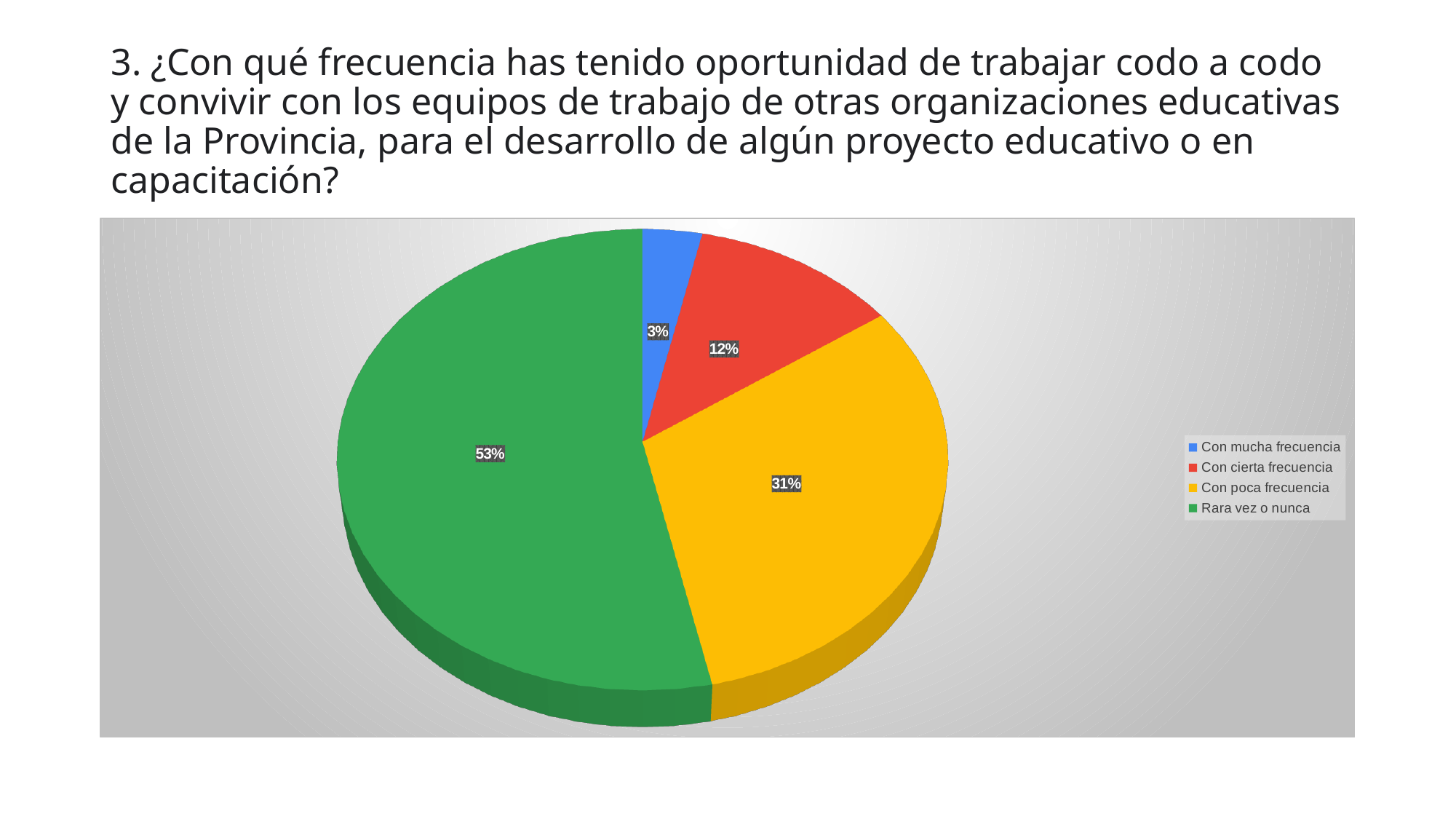
What share of the pie is labelled "Con cierta frecuencia"? 12% What is the difference in percentage points between "Rara vez o nunca" and "Con poca frecuencia"? 22 percentage points What kind of chart is shown on the slide? Pie chart Which is larger, the slice for "Con cierta frecuencia" or the slice for "Con poca frecuencia"? Con poca frecuencia Which legend entry is shown in blue? Con mucha frecuencia What share of the pie is labelled "Con mucha frecuencia"? 3% What share of the pie is labelled "Rara vez o nunca"? 53% What colour is the slice for "Con poca frecuencia"? Yellow Which category has the largest slice of the pie? Rara vez o nunca Which category has the smallest slice of the pie? Con mucha frecuencia How many categories does the pie chart show? 4